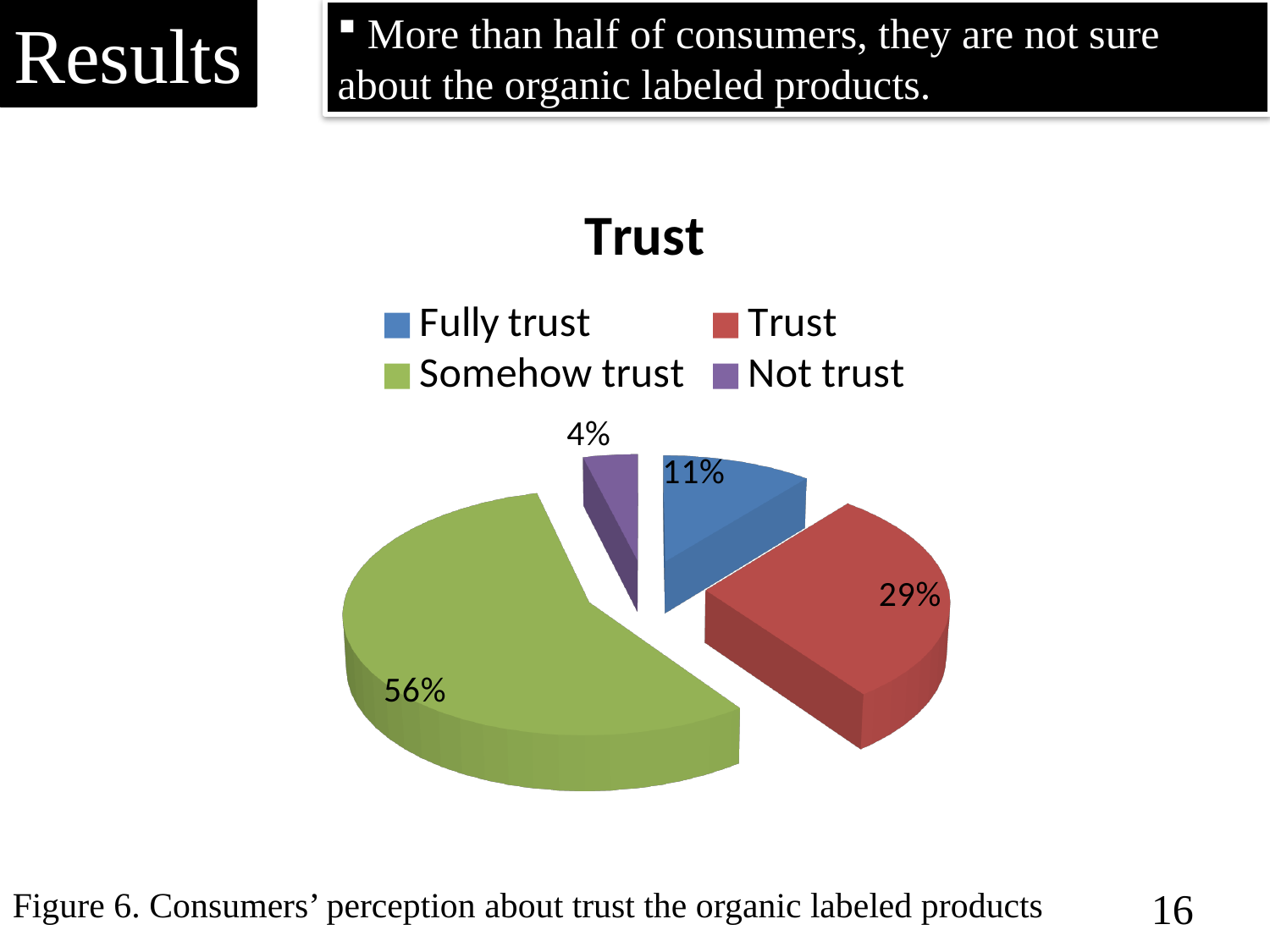
Which category has the largest share of the pie? Somehow trust What percentage of consumers 'Trust' organic labeled products? 29% Which is larger, the share for 'Fully trust' or the share for 'Trust'? Trust What is the chart's title? Trust Which category has the smallest share of the pie? Not trust What percentage of consumers do 'Not trust' organic labeled products? 4% What colour represents 'Somehow trust' in the chart? Green What type of chart is shown on the slide? Pie chart What percentage of consumers 'Somehow trust' organic labeled products? 56% What percentage of consumers 'Fully trust' organic labeled products? 11% How many categories does the legend list? 4 What is the difference in percentage points between 'Somehow trust' and 'Trust'? 27